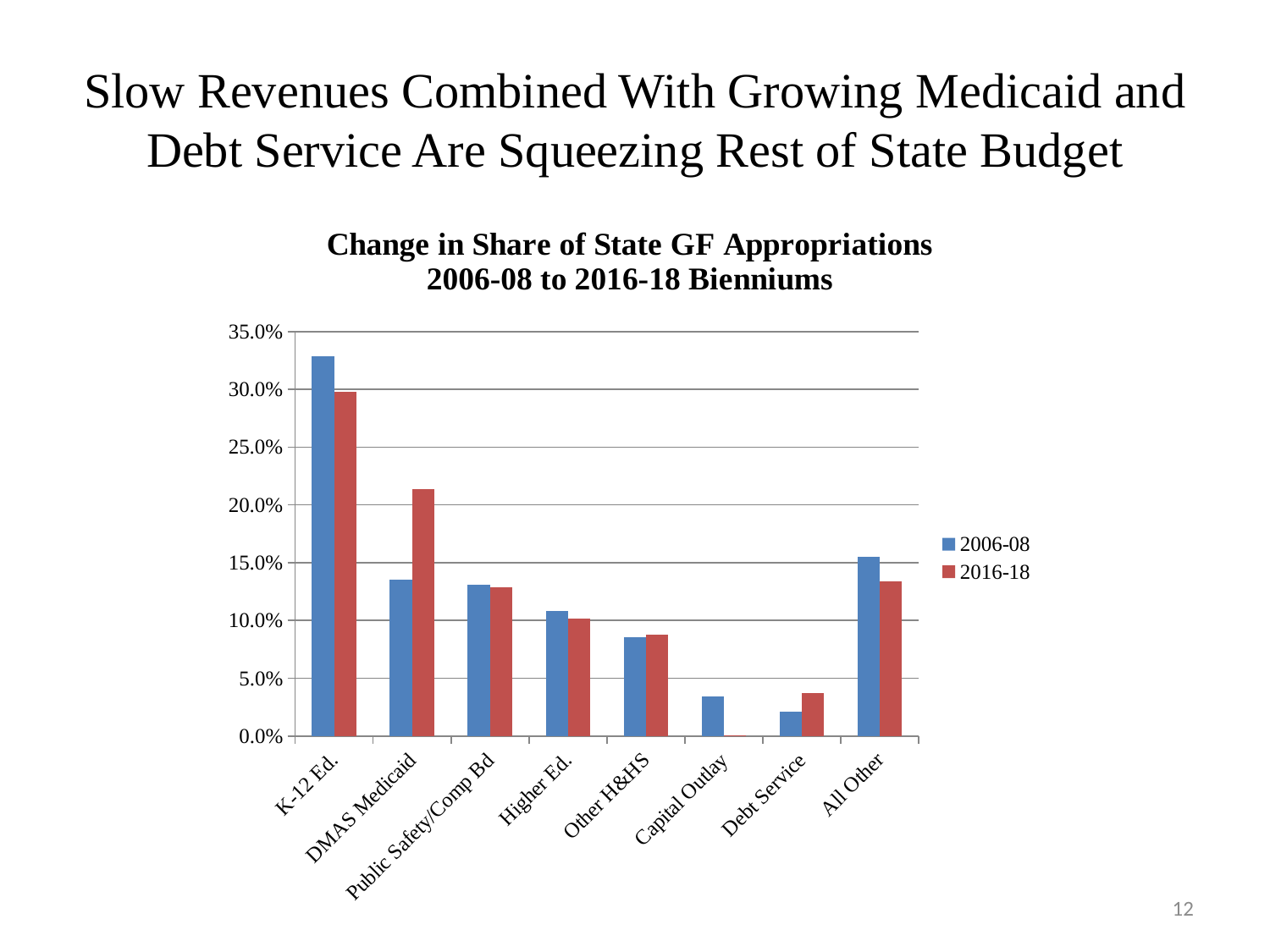
What kind of chart is shown on the slide? bar chart Which category has the highest value for the 2006-08 series? K-12 Ed. For K-12 Ed., which series has the larger value, 2006-08 or 2016-18? 2006-08 Is the 2006-08 value for K-12 Ed. greater or less than 30.0%? greater Which category has the lowest value for the 2006-08 series? Debt Service How many categories are shown on the x axis? 8 Is the 2016-18 value for DMAS Medicaid greater or less than 20.0%? greater Which category has the highest value for the 2016-18 series? K-12 Ed. What is the title of the chart? Change in Share of State GF Appropriations 2006-08 to 2016-18 Bienniums Is the 2016-18 value for Debt Service greater or less than 5.0%? less How many series does the legend list? 2 For DMAS Medicaid, which series has the larger value, 2006-08 or 2016-18? 2016-18